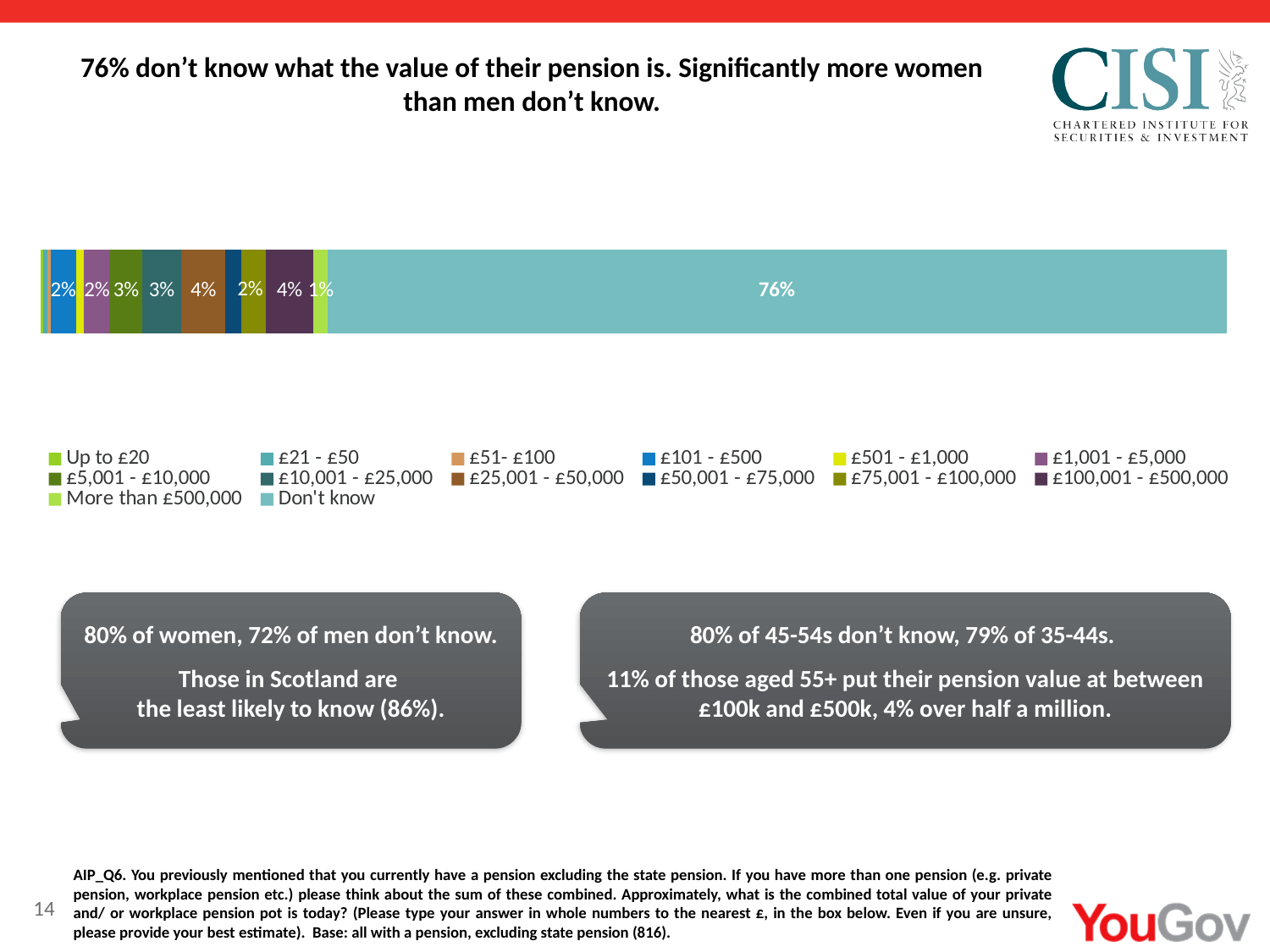
What kind of chart is shown on the slide? Stacked bar chart Which category has the largest share of the bar? Don't know Which is larger, the 'Don't know' segment or the '£21 - £50' segment? Don't know How many categories does the legend list? 14 What is the title of the slide containing the chart? 76% don't know what the value of their pension is. Significantly more women than men don't know. How many percentage data labels are printed on the bar? 9 What percentage of respondents answered 'Don't know' for the value of their pension? 76% What is the last entry listed in the chart legend? Don't know